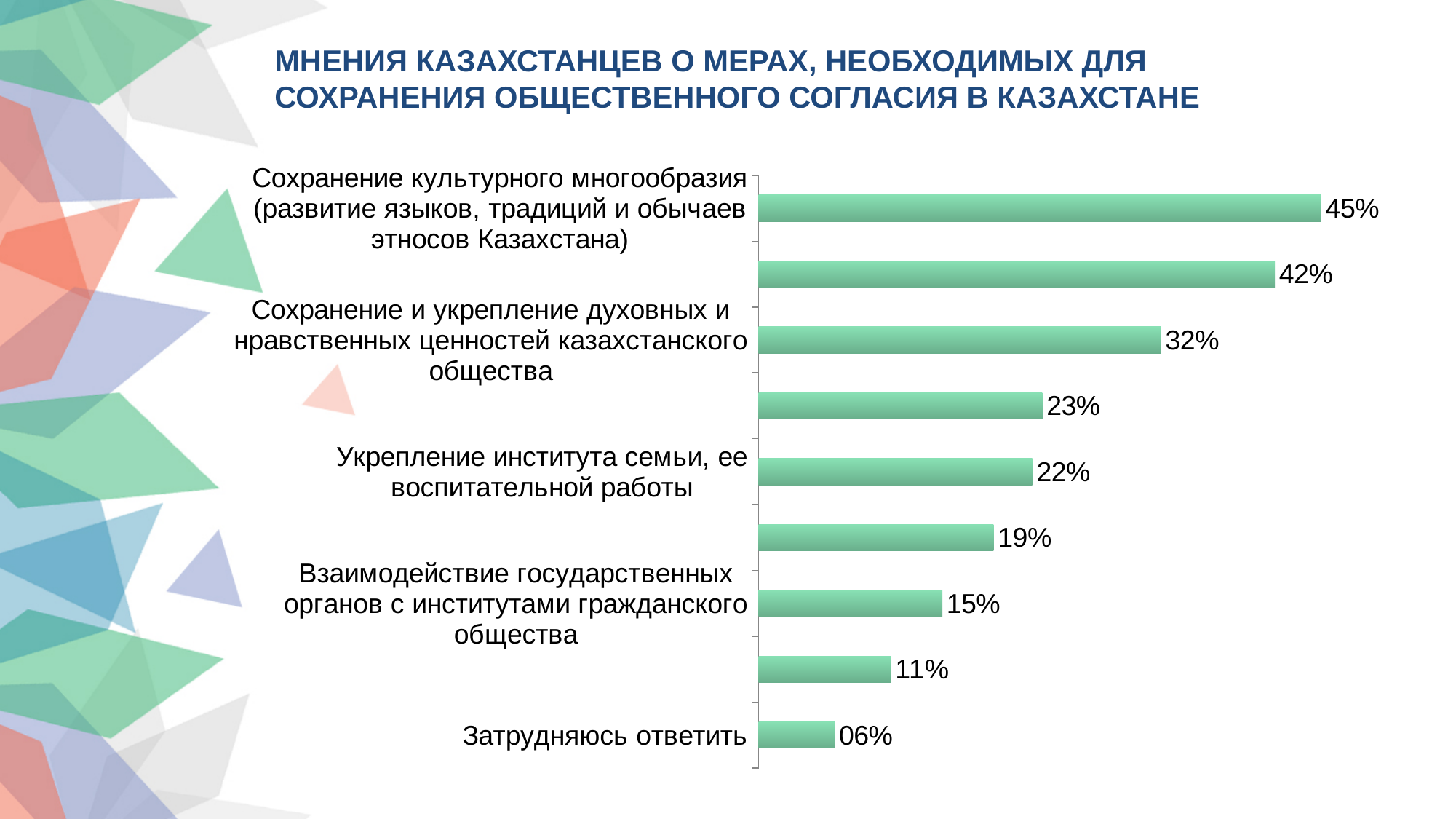
Which bar has the highest value? Сохранение культурного многообразия (развитие языков, традиций и обычаев этносов Казахстана) What kind of chart is shown on the slide? bar chart What is the value for "Укрепление института семьи, ее воспитательной работы"? 22% Which bar has the lowest value? Затрудняюсь ответить Which is larger: the value for "Укрепление института семьи, ее воспитательной работы" or for "Взаимодействие государственных органов с институтами гражданского общества"? Укрепление института семьи, ее воспитательной работы How many bars are plotted in the chart? 9 Do the bar values increase or decrease from the top of the chart to the bottom? decrease What is the value for "Сохранение культурного многообразия (развитие языков, традиций и обычаев этносов Казахстана)"? 45% What is the value for "Взаимодействие государственных органов с институтами гражданского общества"? 15% What is the difference between the values for "Сохранение культурного многообразия" and "Сохранение и укрепление духовных и нравственных ценностей казахстанского общества"? 13% What is the value for "Сохранение и укрепление духовных и нравственных ценностей казахстанского общества"? 32% What is the value for "Затрудняюсь ответить"? 06%